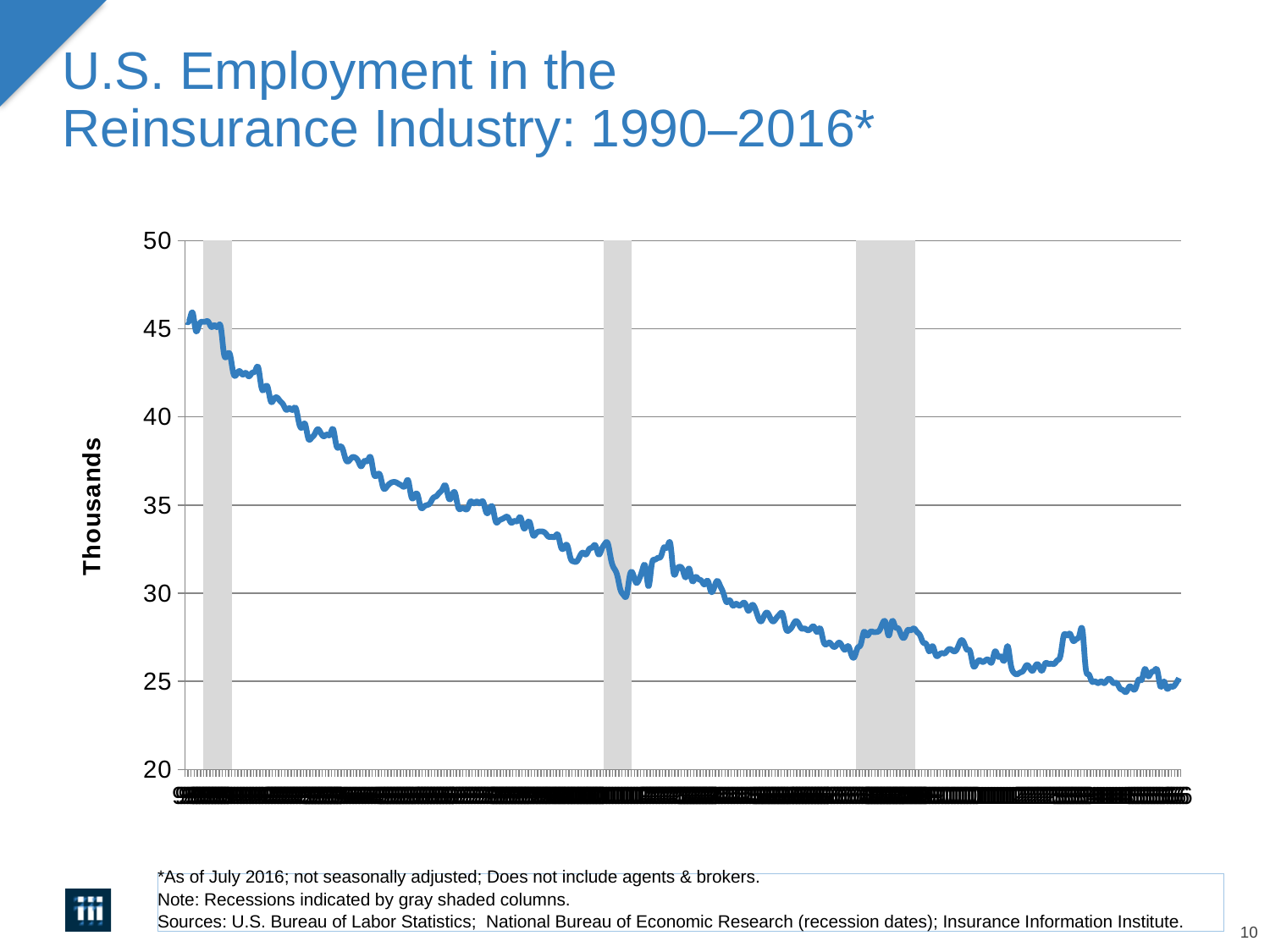
Do the values in the chart generally rise or fall from left to right over 1990–2016? fall What is the label on the vertical axis of the chart? Thousands Is the value at the end of the series (2016) greater or less than 30? less What is the title of the chart? U.S. Employment in the Reinsurance Industry: 1990–2016* What kind of chart is shown on the slide? line chart Is the value at the start of the series (1990) greater or less than 50? less Is the value at the start of the series (1990) greater or less than 40? greater